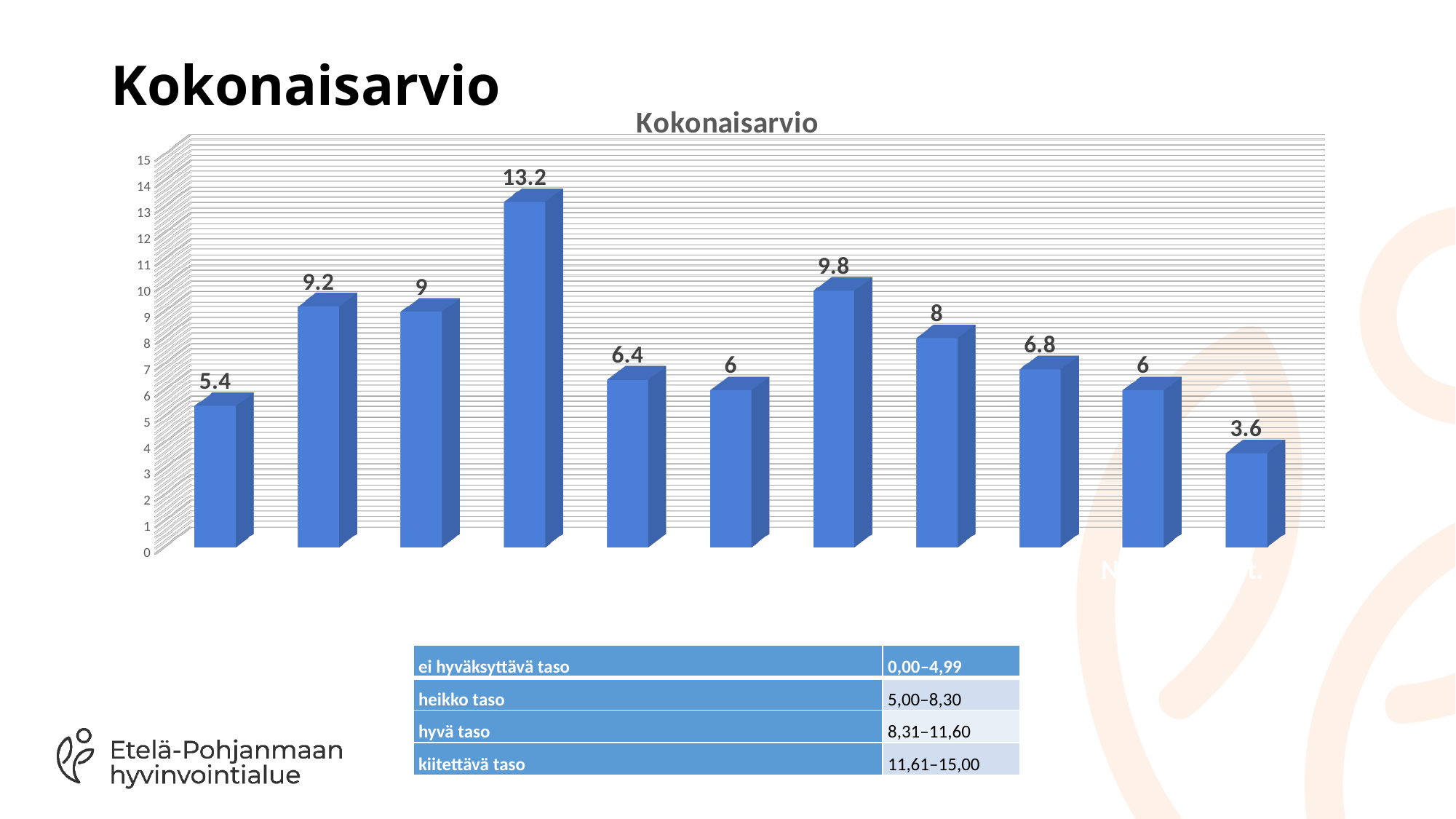
What is the lowest value shown in the chart? 3.6 How many bars are plotted in the chart? 11 Which is larger, the value of the seventh bar from the left or the value of the eighth bar from the left? the seventh bar (9.8) Is the value of the fourth bar from the left greater or less than 10? greater What is the value of the fourth bar from the left? 13.2 What kind of chart is shown on the slide? bar chart What is the value of the last bar on the right? 3.6 What is the difference between the highest and lowest values in the chart? 9.6 What is the highest value shown in the chart? 13.2 What is the value of the first bar from the left? 5.4 What is the title of the chart? Kokonaisarvio What is the difference between the second bar (9.2) and the third bar (9)? 0.2